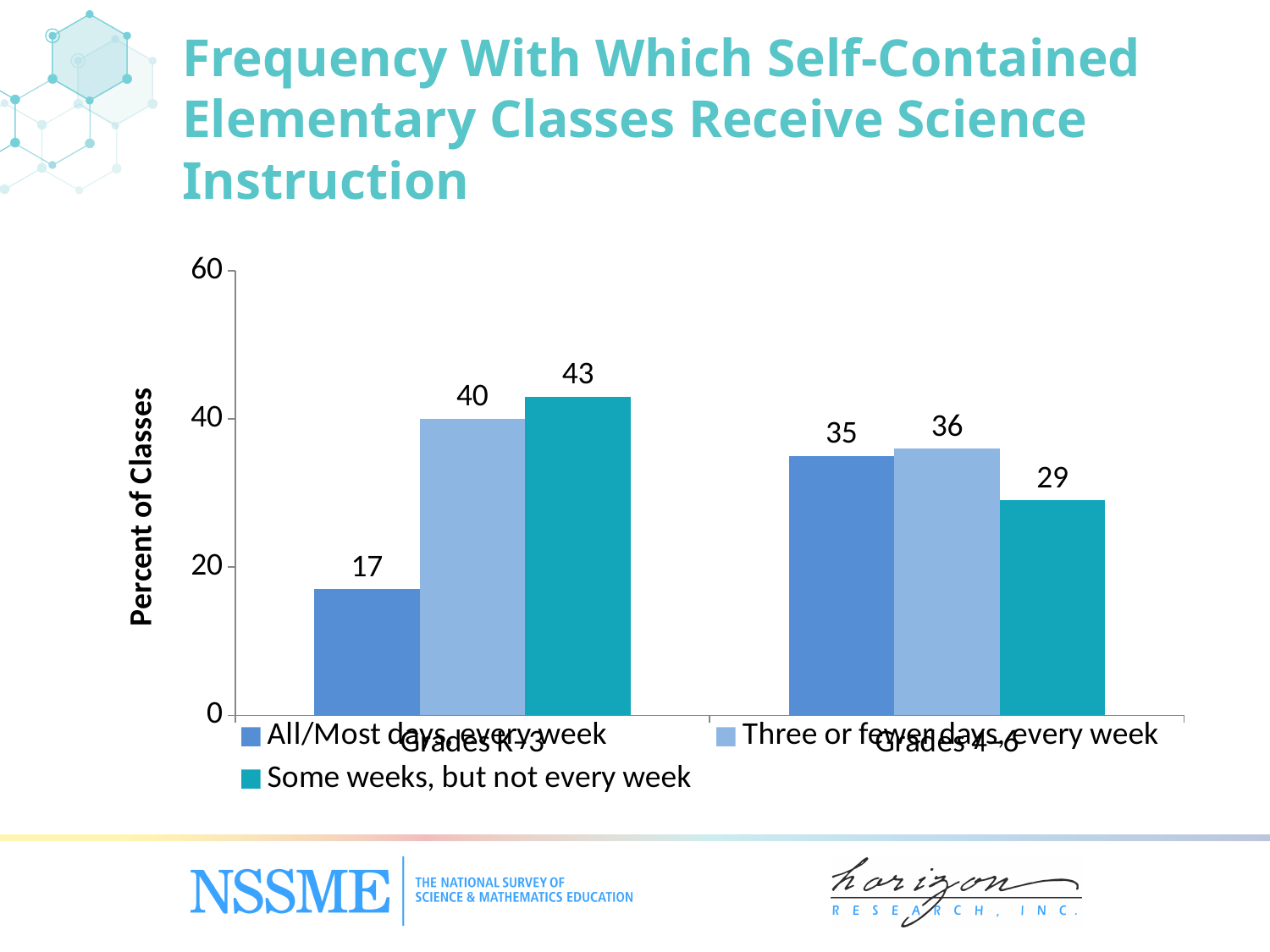
What is the value for 'Three or fewer days, every week' for Grades K-3? 40 What kind of chart is shown on the slide? Bar chart Which is larger: the 'Some weeks, but not every week' value for Grades K-3 or for Grades 4-6? Grades K-3 Which frequency category has the lowest value for Grades 4-6? Some weeks, but not every week How many grade-band categories are shown on the x axis? 2 What is the value for 'Some weeks, but not every week' for Grades 4-6? 29 What percent of Grades K-3 classes receive science instruction all/most days every week? 17 How many series does the legend list? 3 What is the difference between the 'All/Most days, every week' values for Grades 4-6 and Grades K-3? 18 What is the label of the y axis? Percent of Classes Which frequency category has the highest value for Grades K-3? Some weeks, but not every week Is the 'All/Most days, every week' value for Grades K-3 greater or less than 20? less